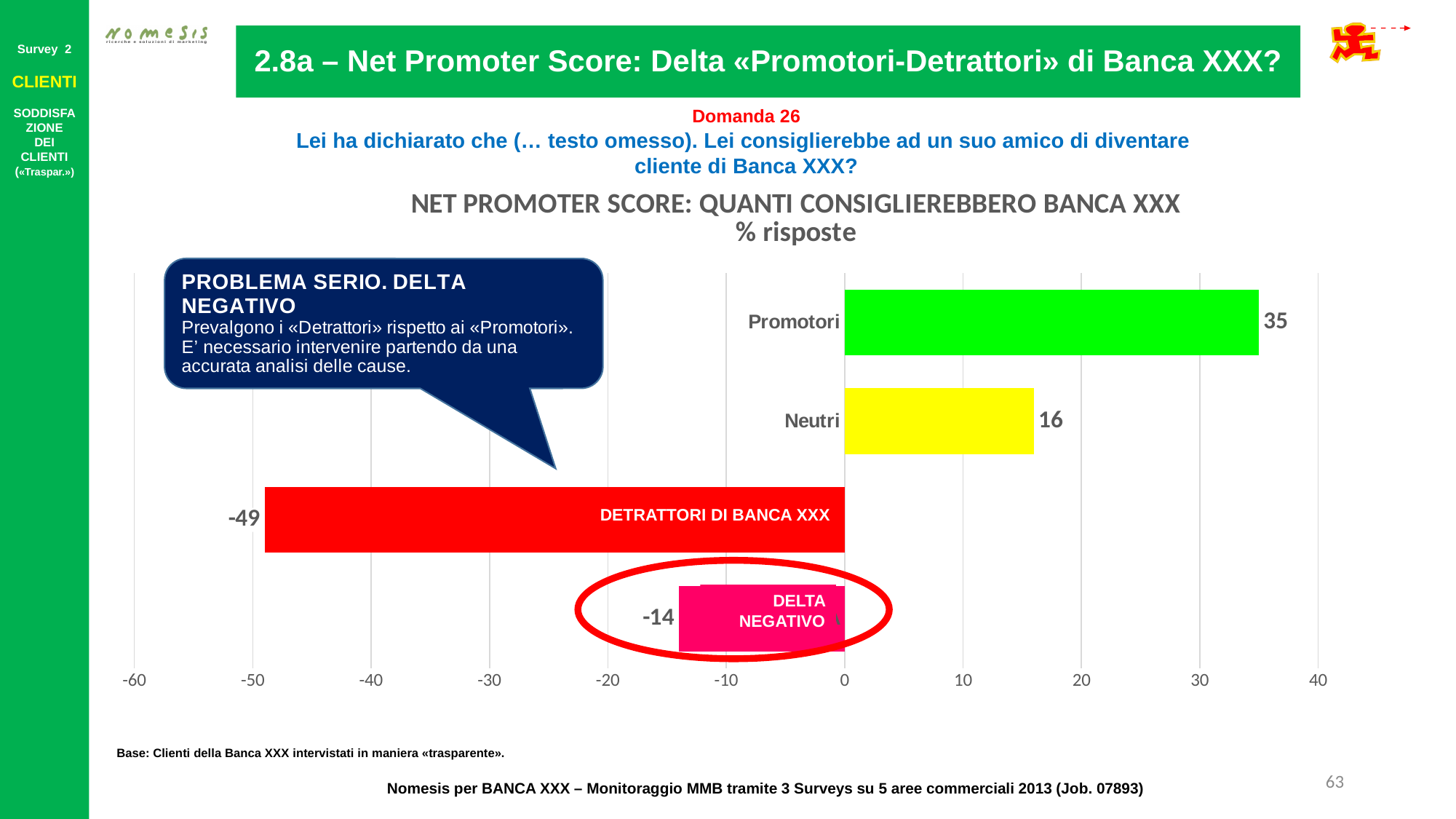
Which category has the highest value? Promotori Is the value for Detrattori di Banca XXX greater or less than -40? less What is the value of the Delta Negativo bar? -14 Which is larger, the value for Promotori or the value for Neutri? Promotori Which category has the lowest value? Detrattori di Banca XXX What kind of chart is shown on the slide? Bar chart What is the value for Promotori? 35 What is the value for Detrattori di Banca XXX? -49 What is the value for Neutri? 16 What colour is the Detrattori di Banca XXX bar? Red What is the difference between the Promotori value and the Neutri value? 19 How many bars are plotted in the chart? 4